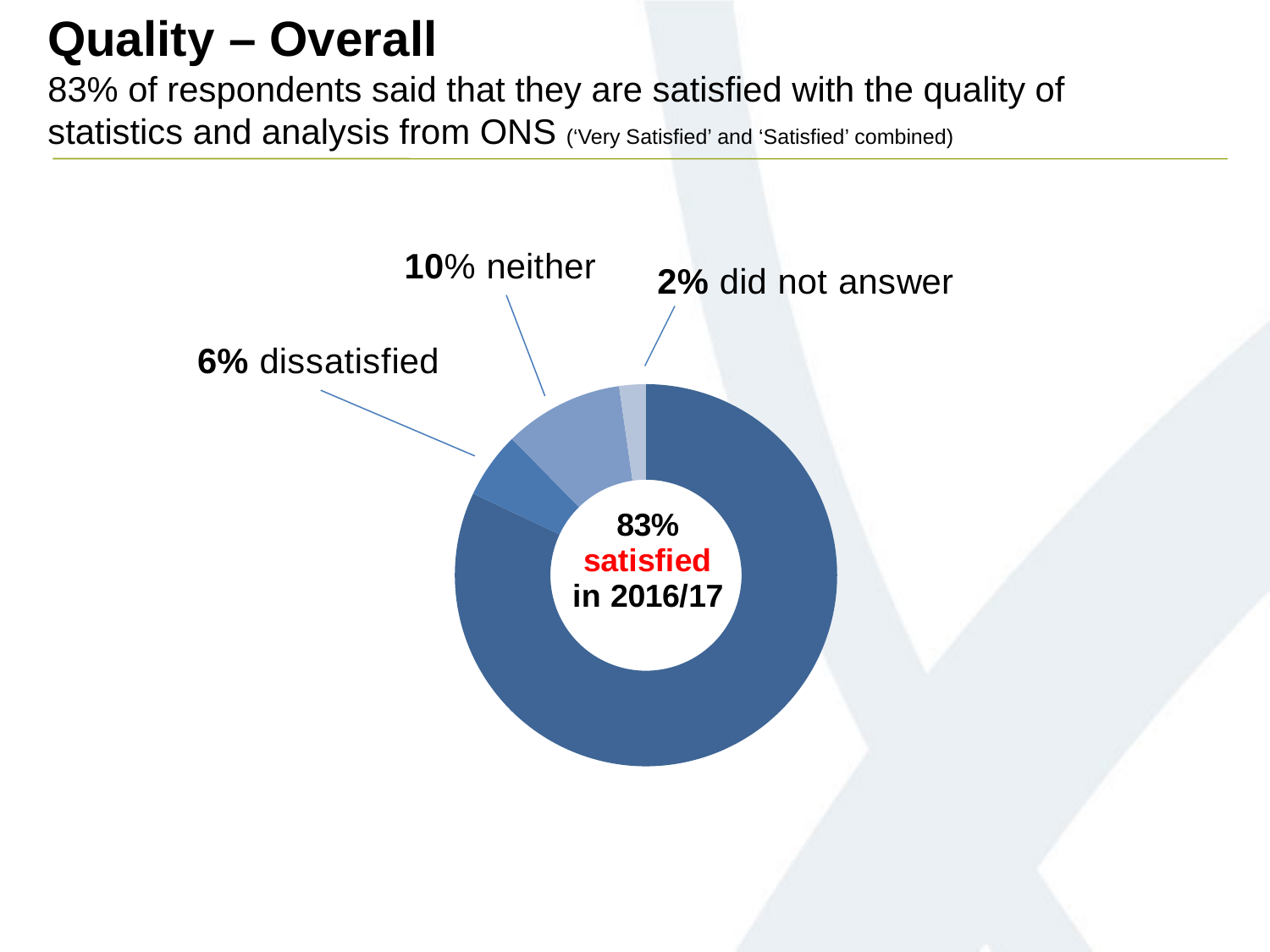
What percentage of respondents were satisfied with the quality of statistics and analysis from ONS in 2016/17? 83% What is the combined share of respondents who were dissatisfied or did not answer? 8% What percentage of respondents answered 'neither'? 10% What is the difference in percentage points between the 'neither' share and the 'dissatisfied' share? 4 Which is larger, the share of respondents who were dissatisfied or the share who answered 'neither'? neither What kind of chart is shown on the slide? doughnut (pie) chart How many categories are shown in the chart? 4 What percentage of respondents did not answer? 2% What percentage of respondents were dissatisfied? 6% What year does the text in the centre of the chart refer to? 2016/17 Which category has the largest share of the chart? satisfied Which category has the smallest share of the chart? did not answer